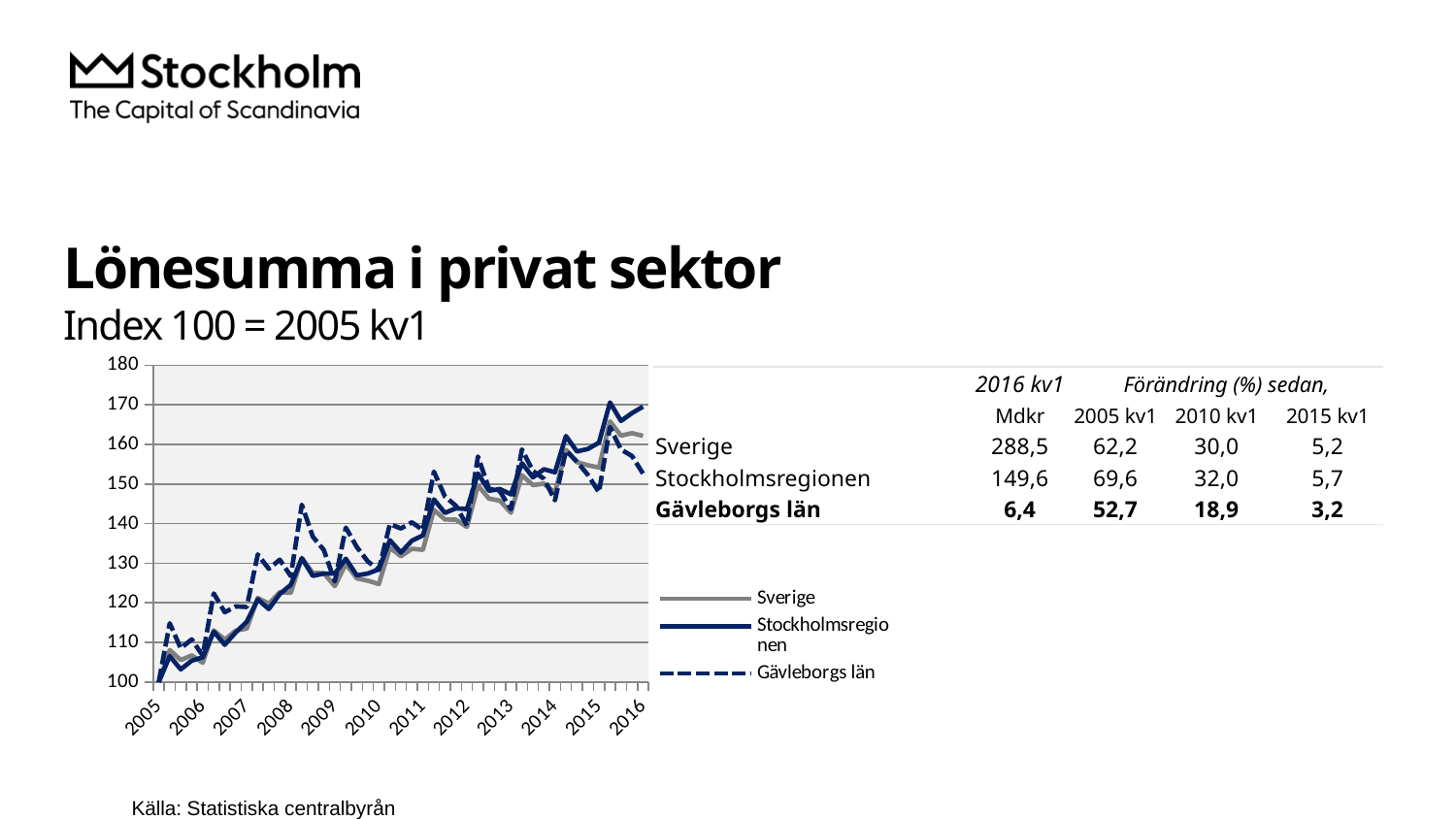
What is the index value for all series at 2005 kv1, the base period of the chart? 100 Is the value for Stockholmsregionen at the end of the series in 2016 greater or less than 160? greater What is the title of the chart on the slide? Lönesumma i privat sektor How many year labels are shown on the x axis of the chart? 12 What kind of chart is shown on the slide? line chart Which series reaches the highest index value at the end of the chart in 2016? Stockholmsregionen Is the value for Gävleborgs län at the end of the series in 2016 greater or less than 160? less Is the value for Sverige at the end of the series in 2016 greater or less than 150? greater Which series in the chart is drawn with a dashed line? Gävleborgs län At the end of the series in 2016, which is higher: Stockholmsregionen or Gävleborgs län? Stockholmsregionen Do the index values for Stockholmsregionen generally rise or fall from 2005 to 2016? rise How many series does the chart legend list? 3